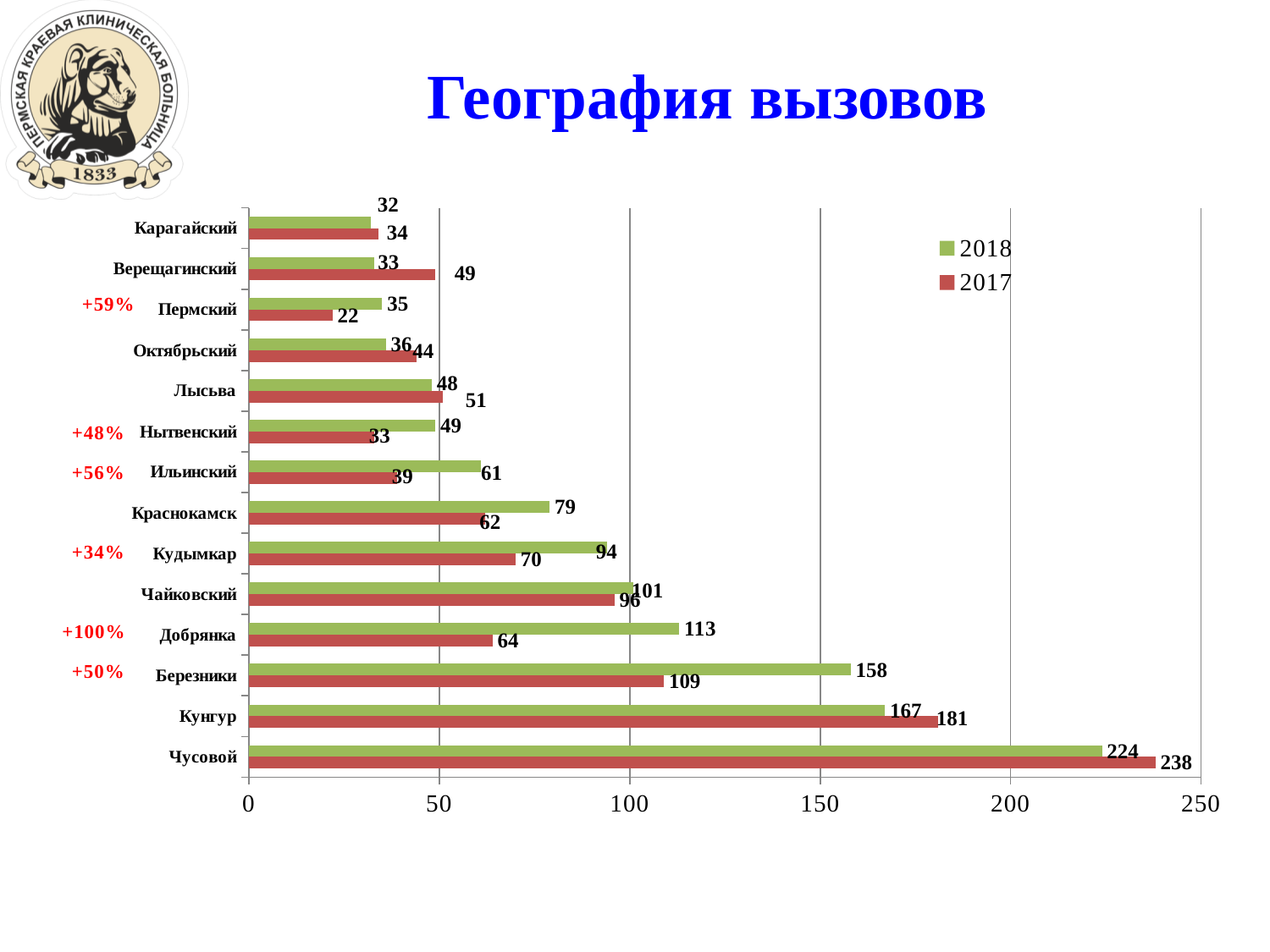
How many categories are shown on the chart? 14 What is the 2018 value for Добрянка? 113 What is the difference between the 2018 and 2017 values for Березники? 49 What is the 2017 value for Кунгур? 181 What type of chart is shown on the slide? bar chart What is the title of the chart? География вызовов Which category has the highest 2018 value? Чусовой What is the 2017 value for Ильинский? 39 Which category has the lowest 2017 value? Пермский Which is larger for Чайковский, the 2018 value or the 2017 value? 2018 How many series does the legend list? 2 What is the difference between the 2017 and 2018 values for Чусовой? 14